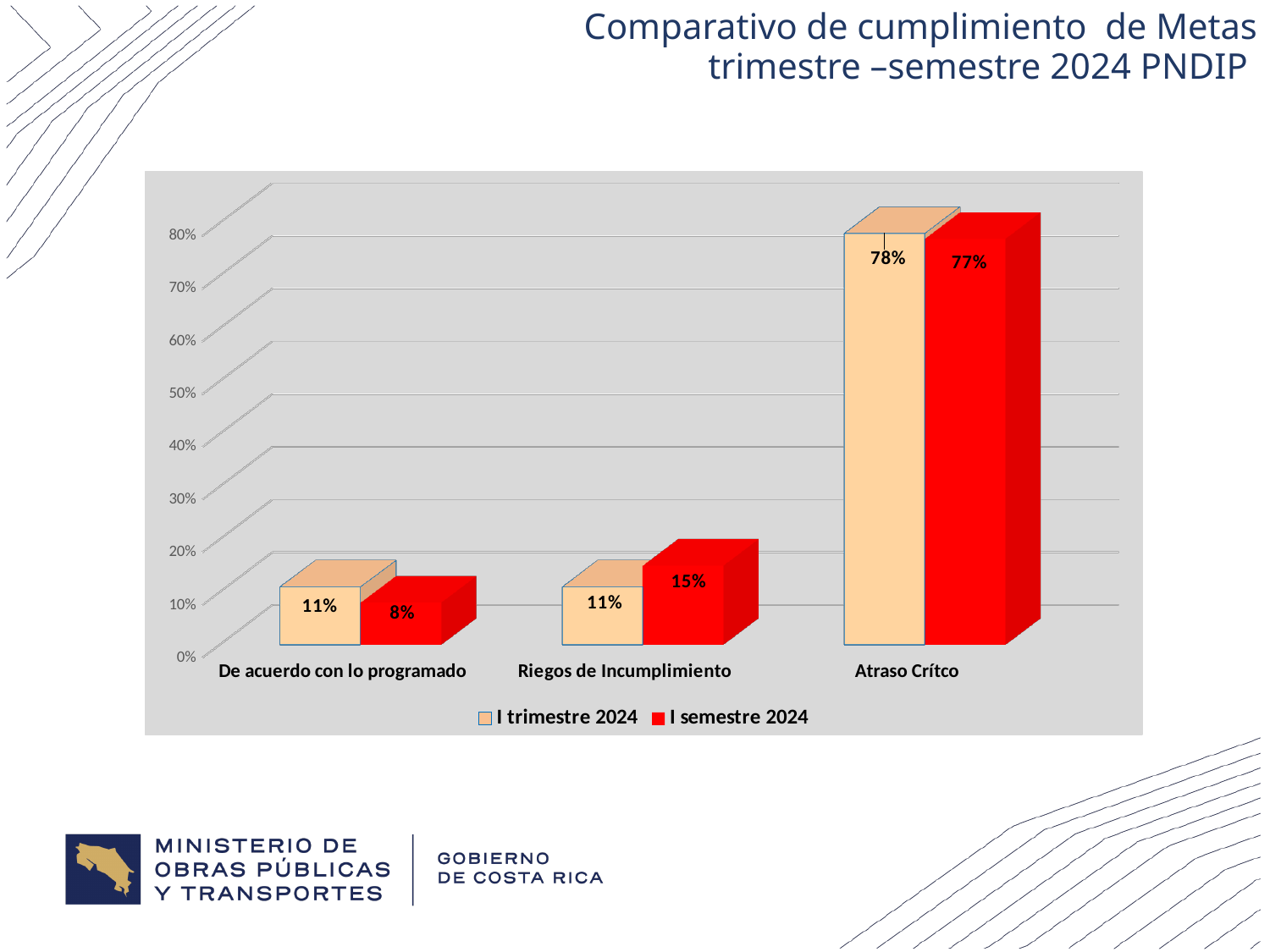
How many series does the legend list? 2 What is the difference between the 'I trimestre 2024' and 'I semestre 2024' values for 'Atraso Crítco'? 1% What is the value for 'Riegos de Incumplimiento' in the 'I semestre 2024' series? 15% Which category has the highest value in the 'I semestre 2024' series? Atraso Crítco For 'De acuerdo con lo programado', which series has the larger value, 'I trimestre 2024' or 'I semestre 2024'? I trimestre 2024 What is the difference between the 'I trimestre 2024' and 'I semestre 2024' values for 'Riegos de Incumplimiento'? 4% What is the value for 'Atraso Crítco' in the 'I trimestre 2024' series? 78% What is the value for 'De acuerdo con lo programado' in the 'I semestre 2024' series? 8% How many categories are shown on the x axis? 3 Which category has the lowest value in the 'I semestre 2024' series? De acuerdo con lo programado Is the 'I semestre 2024' value for 'Atraso Crítco' greater or less than 50%? greater What kind of chart is shown on the slide? Bar chart